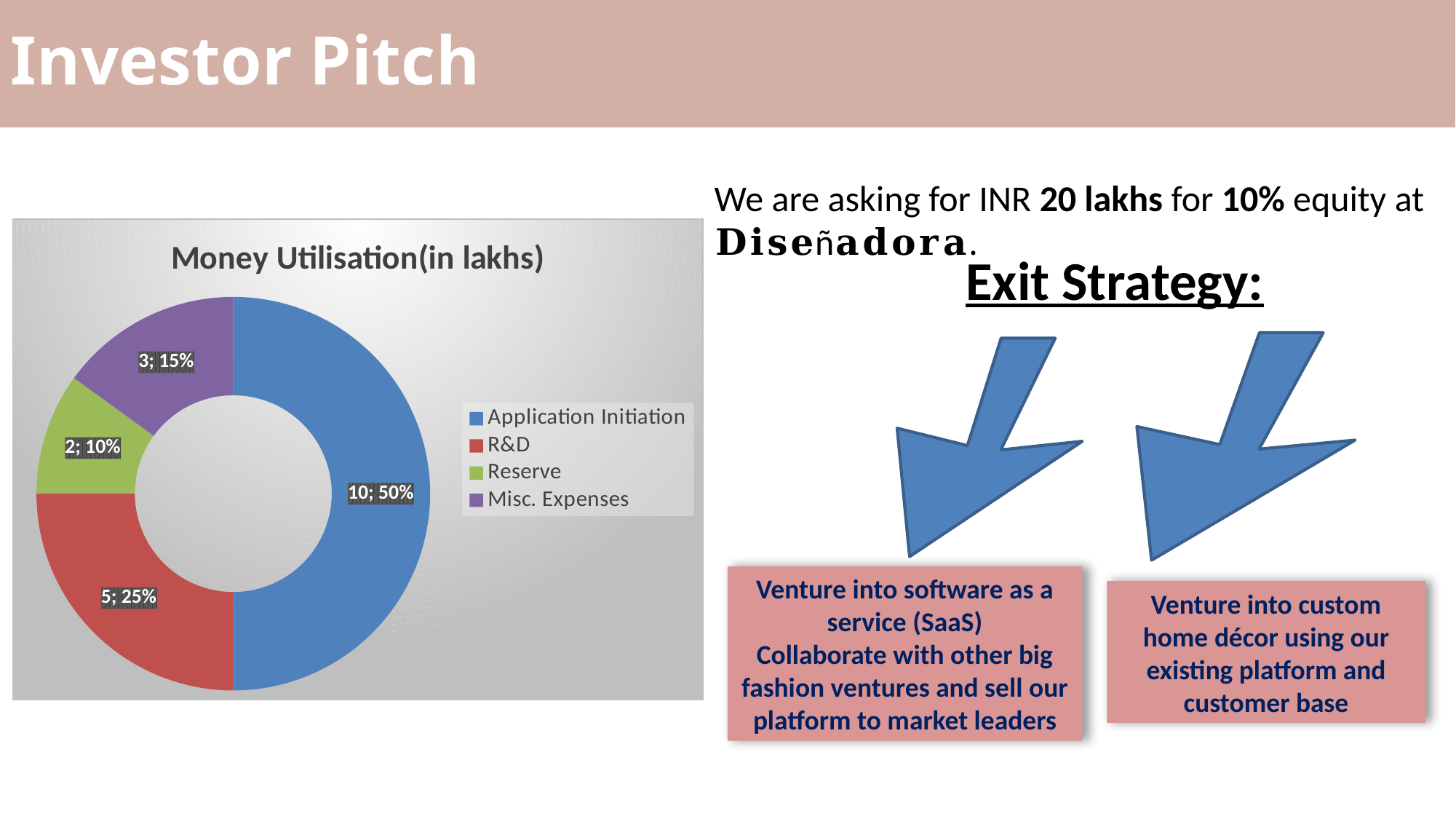
What is the difference in lakhs between Application Initiation and R&D? 5 How many categories does the chart show? 4 What value (in lakhs) is shown for Misc. Expenses? 3 What kind of chart is shown on the slide? Doughnut chart What value (in lakhs) is shown for Application Initiation? 10 Which category has the largest value? Application Initiation What value (in lakhs) is shown for R&D? 5 What is the title of the chart? Money Utilisation(in lakhs) Which category has the smallest value? Reserve What share of the chart does Application Initiation represent? 50% What share of the chart does Misc. Expenses represent? 15% What value (in lakhs) is shown for Reserve? 2